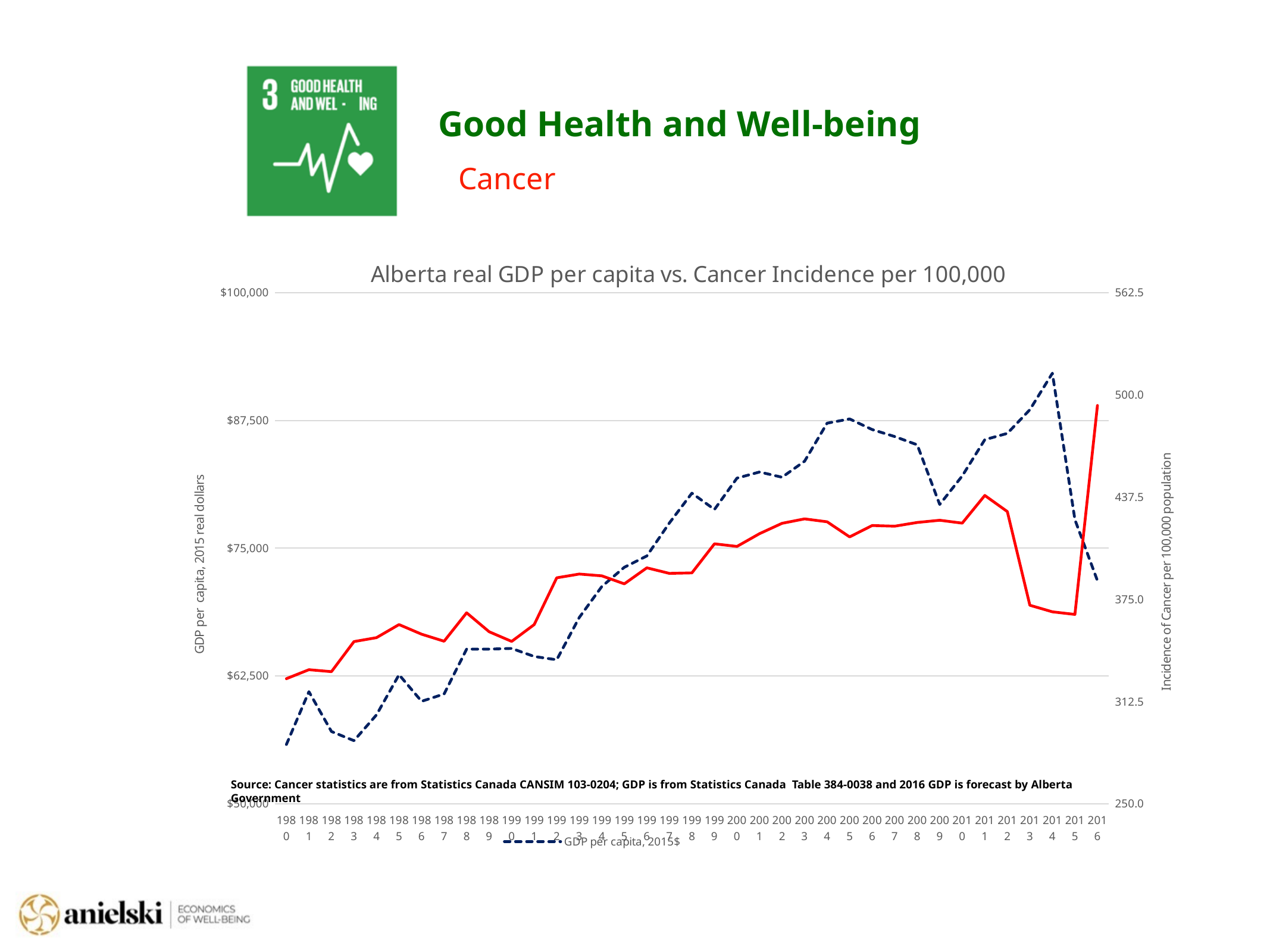
Is the cancer incidence value for 2016 greater or less than 437.5? greater In which year does the GDP per capita line reach its highest value? 2014 Is the GDP per capita value for 1980 greater or less than $62,500? less In which year does the cancer incidence line reach its highest value? 2016 Which year has the higher GDP per capita, 2014 or 2016? 2014 How many years are plotted along the x axis? 37 What is the title of the chart? Alberta real GDP per capita vs. Cancer Incidence per 100,000 Is the GDP per capita value for 2014 greater or less than $87,500? greater Does the GDP per capita line generally rise or fall from 1980 to 2014? rise What is the label of the left vertical axis? GDP per capita, 2015 real dollars What kind of chart is shown on the slide? line chart